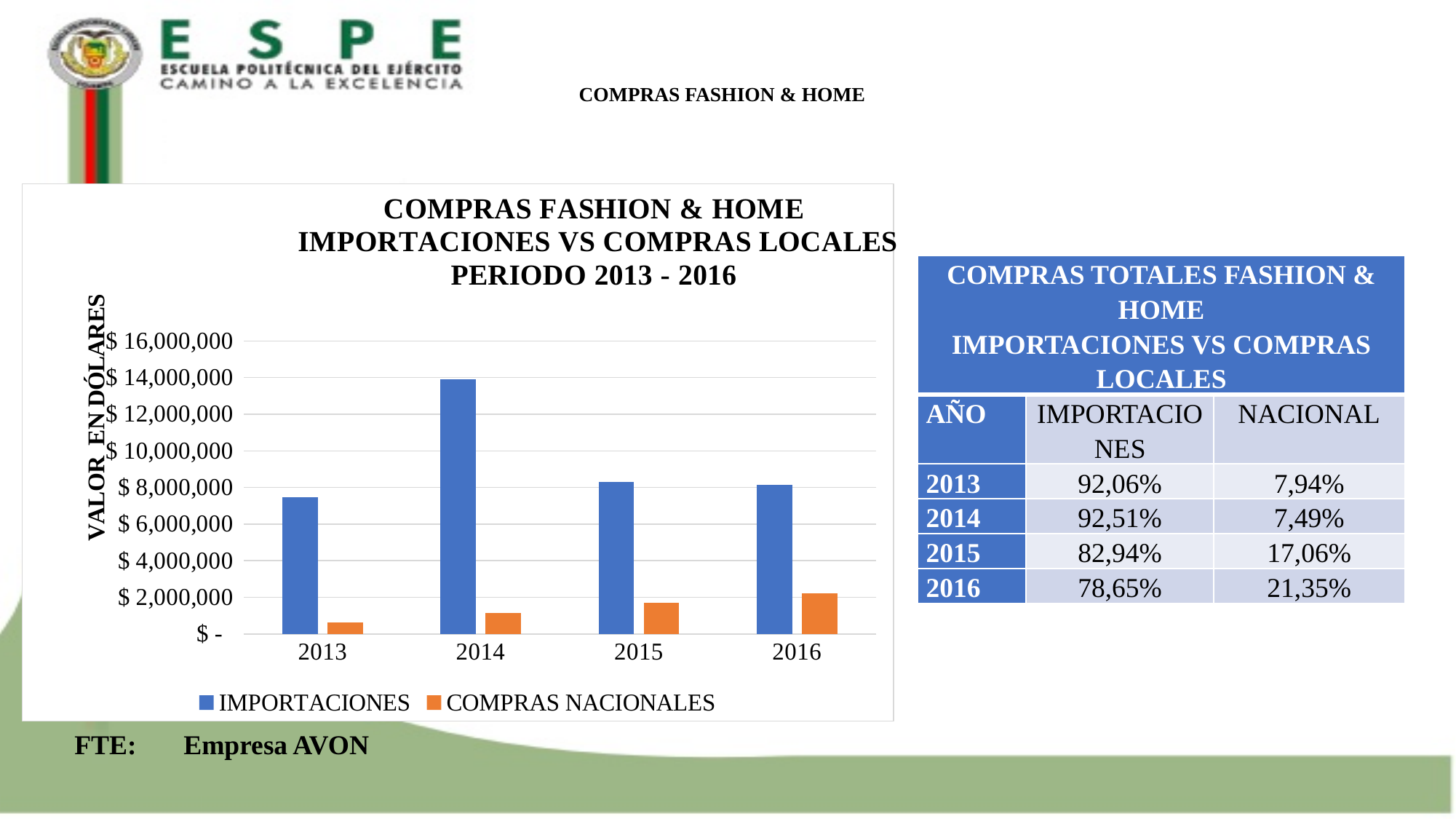
What kind of chart is shown on the slide? bar chart In which year is the COMPRAS NACIONALES bar the lowest? 2013 In 2013, which is larger: IMPORTACIONES or COMPRAS NACIONALES? IMPORTACIONES In which year is the IMPORTACIONES bar the highest? 2014 How many series does the chart legend list? 2 Is the COMPRAS NACIONALES value for 2015 greater or less than $ 2,000,000? less In which year is the IMPORTACIONES bar the lowest? 2013 How many years are shown on the x axis of the chart? 4 In which year is the COMPRAS NACIONALES bar the highest? 2016 Is the IMPORTACIONES value for 2014 greater or less than $ 12,000,000? greater Do the COMPRAS NACIONALES values rise or fall from 2013 to 2016? rise What is the title of the vertical axis of the chart? VALOR EN DÓLARES